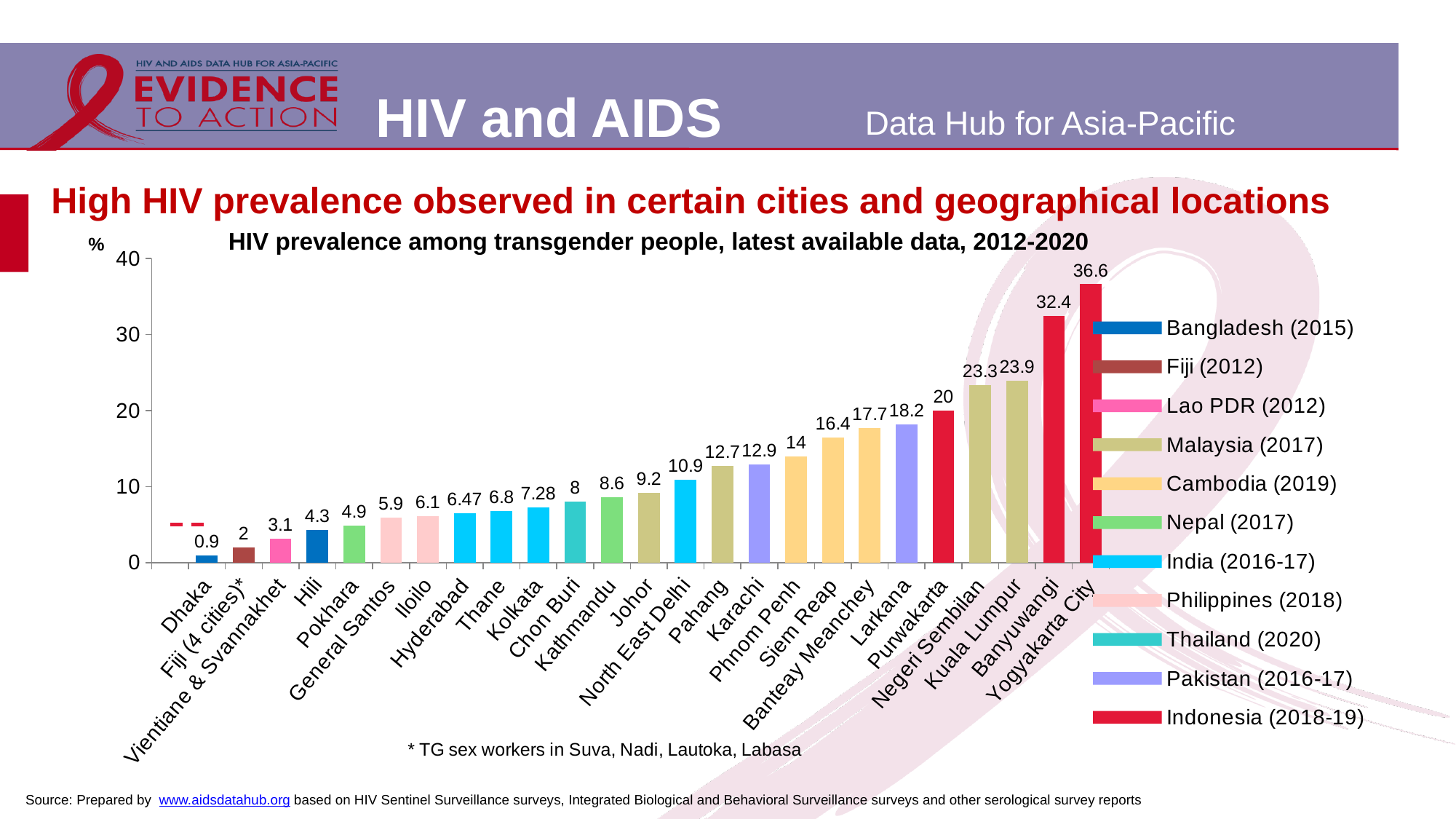
What is the value shown for Hyderabad? 6.47 How many locations are plotted on the x axis of the chart? 25 How many countries does the legend list? 11 Do the values rise or fall moving from left to right along the x axis? Rise What is the HIV prevalence value shown for Yogyakarta City? 36.6 Which location has the lowest HIV prevalence in the chart? Dhaka Which location has the highest HIV prevalence in the chart? Yogyakarta City Is the value for Purwakarta greater or less than 10? greater Which has a higher value, Siem Reap or Phnom Penh? Siem Reap What is the difference between the values for Banyuwangi and Yogyakarta City? 4.2 What is the value shown for Kathmandu? 8.6 What kind of chart is shown on the slide? Bar chart